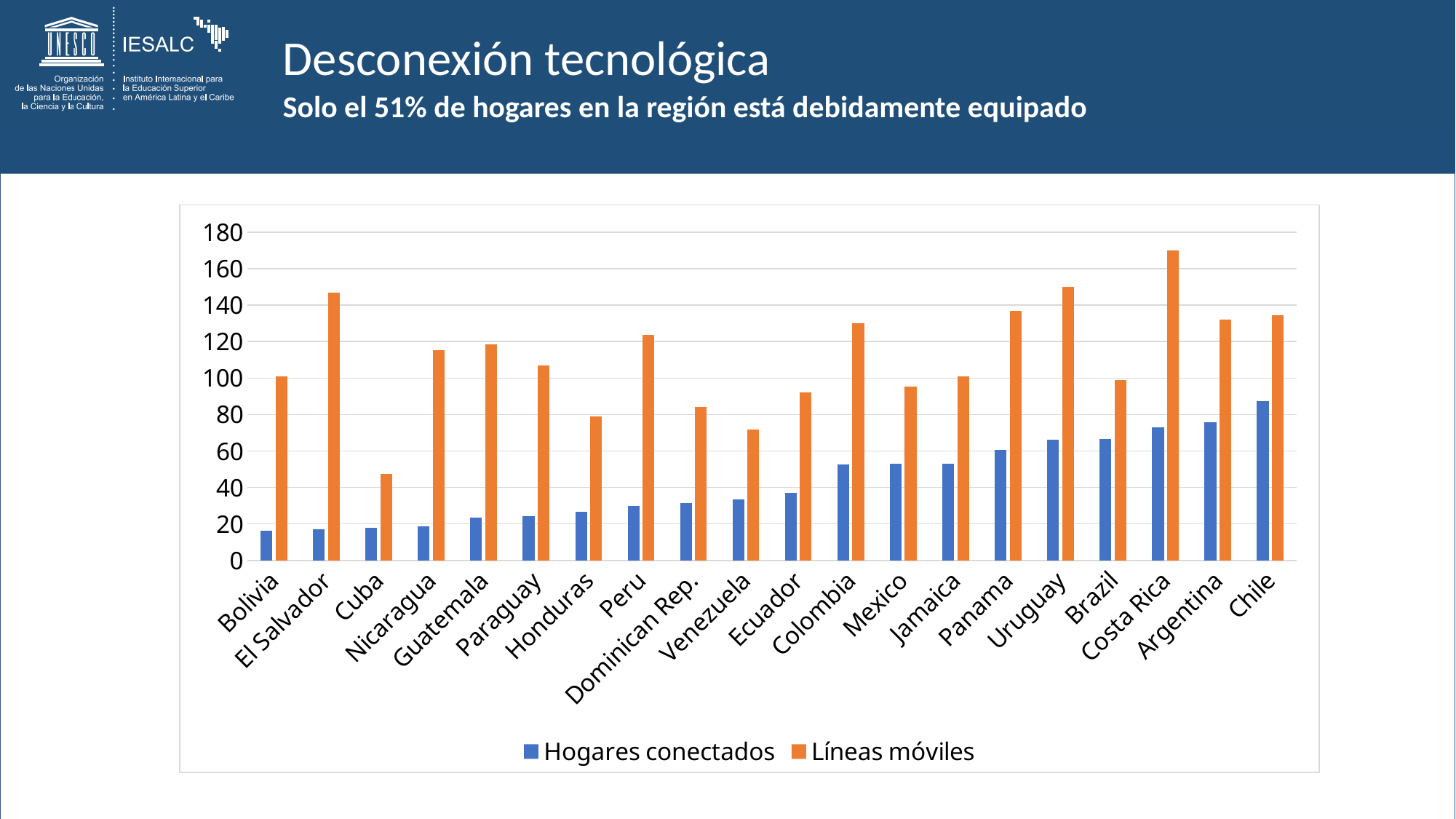
How many countries are shown on the x axis? 20 Which country has the highest value for Hogares conectados? Chile How many series does the legend list? 2 Which colour represents Líneas móviles in the chart? Orange Which country has the highest value for Líneas móviles? Costa Rica Which country has the lowest value for Líneas móviles? Cuba Do the Hogares conectados values rise or fall from Bolivia to Chile along the x axis? rise Is the Líneas móviles value for Cuba greater or less than 60? less Is the Líneas móviles value for Costa Rica greater or less than 160? greater Which has the larger Líneas móviles value, El Salvador or Nicaragua? El Salvador What kind of chart is shown on the slide? Bar chart Is the Hogares conectados value for Chile greater or less than 80? greater